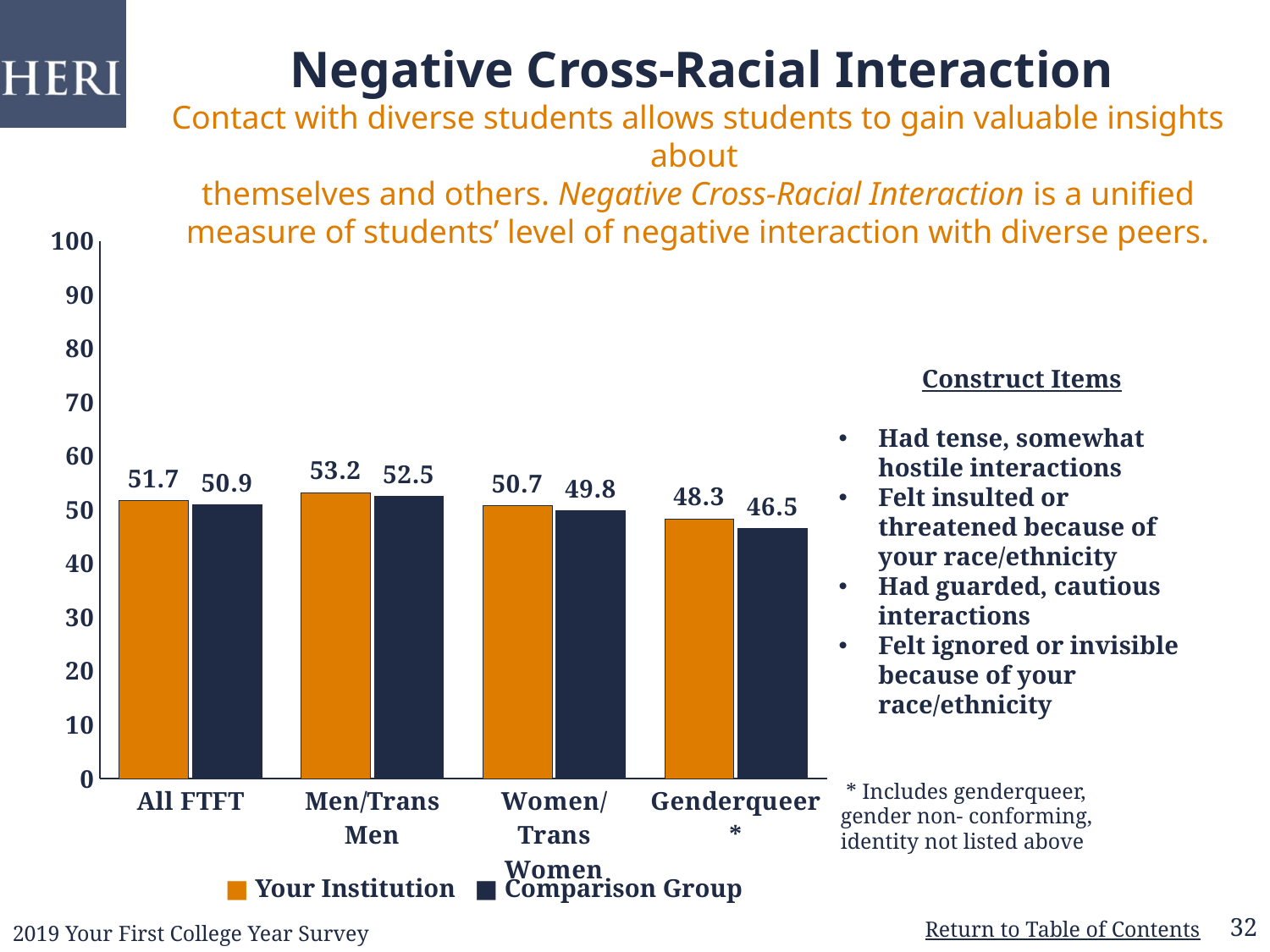
Which category has the lowest Comparison Group value? Genderqueer What is the Your Institution value for All FTFT? 51.7 Which category has the highest Your Institution value? Men/Trans Men Which is larger for Men/Trans Men: the Your Institution value or the Comparison Group value? Your Institution How many series does the legend list? 2 How many categories are shown on the x axis? 4 What is the Comparison Group value for Genderqueer? 46.5 Is the Comparison Group value for All FTFT greater or less than 60? less What is the difference between the Your Institution and Comparison Group values for Genderqueer? 1.8 What kind of chart is shown on the slide? bar chart What is the Your Institution value for Women/Trans Women? 50.7 What is the difference between the Your Institution values for Men/Trans Men and Women/Trans Women? 2.5